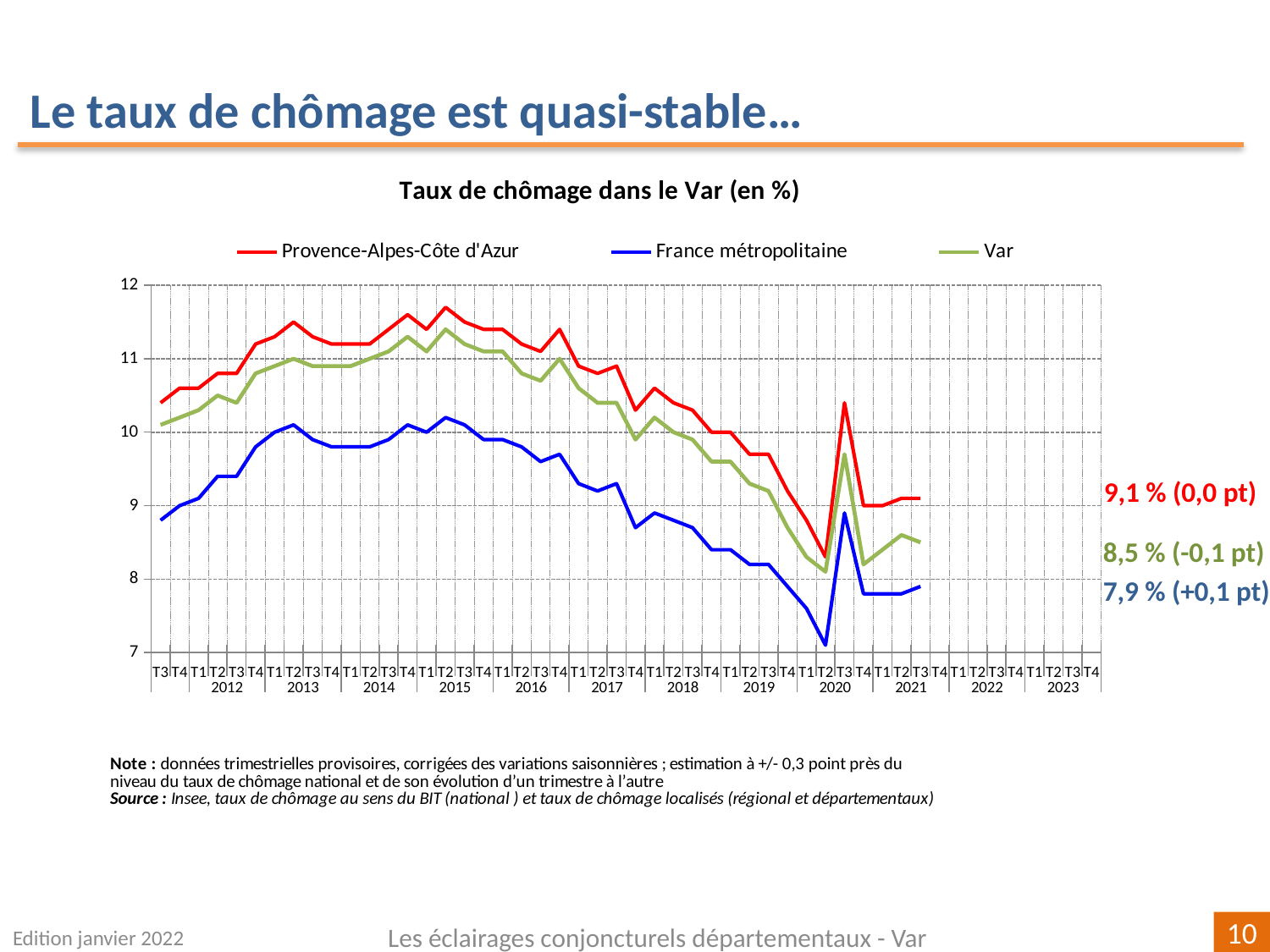
How many series does the legend list? 3 What is the title of the chart? Taux de chômage dans le Var (en %) What is the latest unemployment rate shown for France métropolitaine? 7,9 % Which series has the lowest values across the whole period? France métropolitaine What is the latest unemployment rate shown for Provence-Alpes-Côte d'Azur? 9,1 % What kind of chart is shown on the slide? line chart Is the value for France métropolitaine in T2 2020 greater or less than 8? less What quarterly change in points is annotated for the Var? -0,1 pt What is the latest unemployment rate shown for the Var? 8,5 % What is the difference between the latest rates for Provence-Alpes-Côte d'Azur and France métropolitaine? 1,2 % Between 2015 and 2019, does the unemployment rate for the Var rise or fall overall? fall At the end of the series, which is higher: the rate for Provence-Alpes-Côte d'Azur or for France métropolitaine? Provence-Alpes-Côte d'Azur